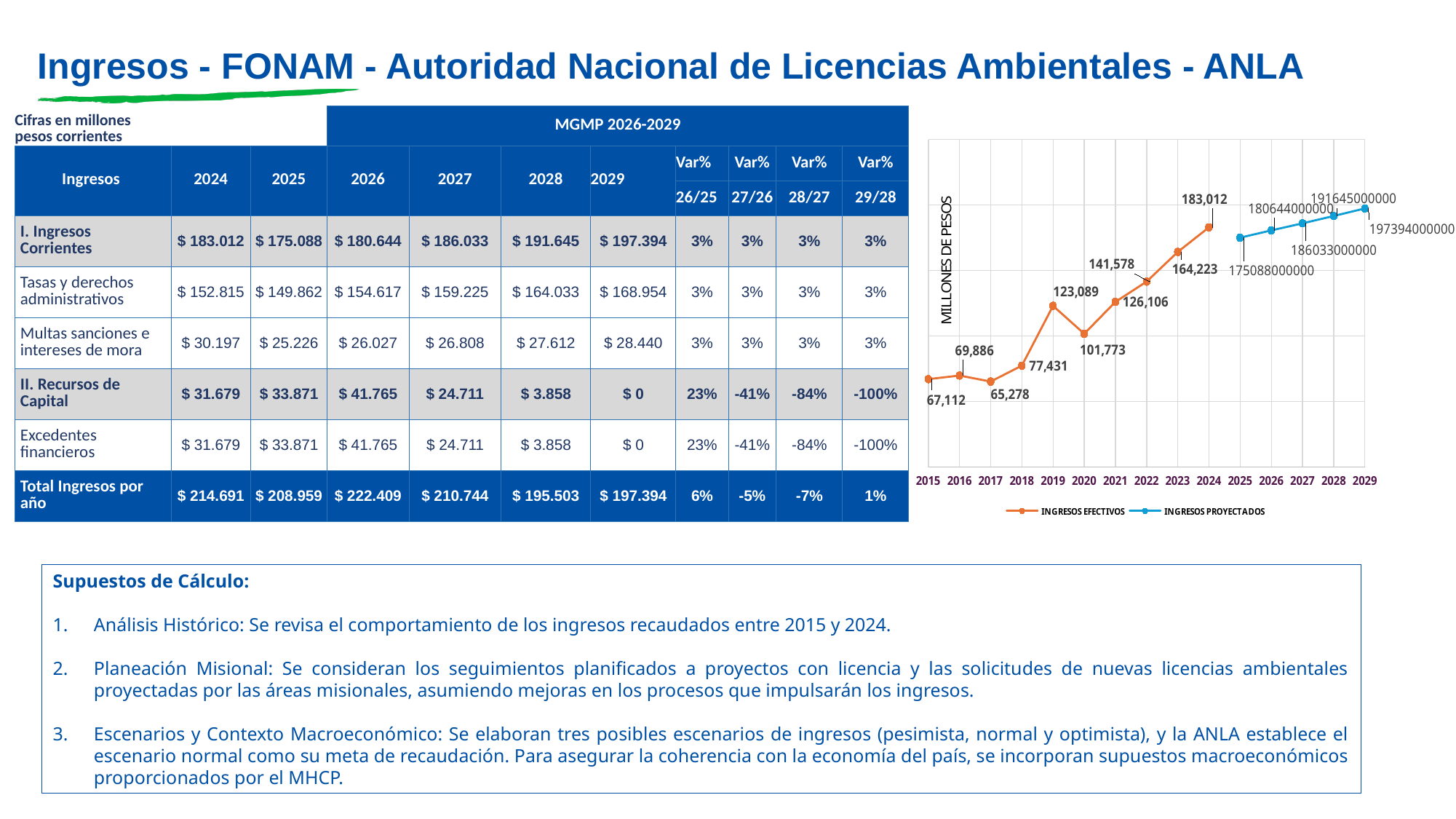
In the line chart, do the INGRESOS PROYECTADOS values rise or fall from 2025 to 2029? rise What type of chart is shown on the right side of the slide? line chart In the line chart, what is the value of INGRESOS PROYECTADOS for 2029? 197394000000 In the line chart, what is the difference between the INGRESOS EFECTIVOS values for 2019 and 2020? 21,316 In the line chart, which year has the lowest value of INGRESOS EFECTIVOS? 2017 How many series does the legend of the line chart list? 2 In the line chart, what is the value of INGRESOS EFECTIVOS for 2019? 123,089 In the line chart, which year has the highest value of INGRESOS EFECTIVOS? 2024 In the line chart, what is the value of INGRESOS EFECTIVOS for 2024? 183,012 How many years are shown on the x axis of the line chart? 15 In the line chart, which is larger: the INGRESOS EFECTIVOS value for 2021 or for 2020? 2021 In the line chart, what is the value of INGRESOS EFECTIVOS for 2017? 65,278